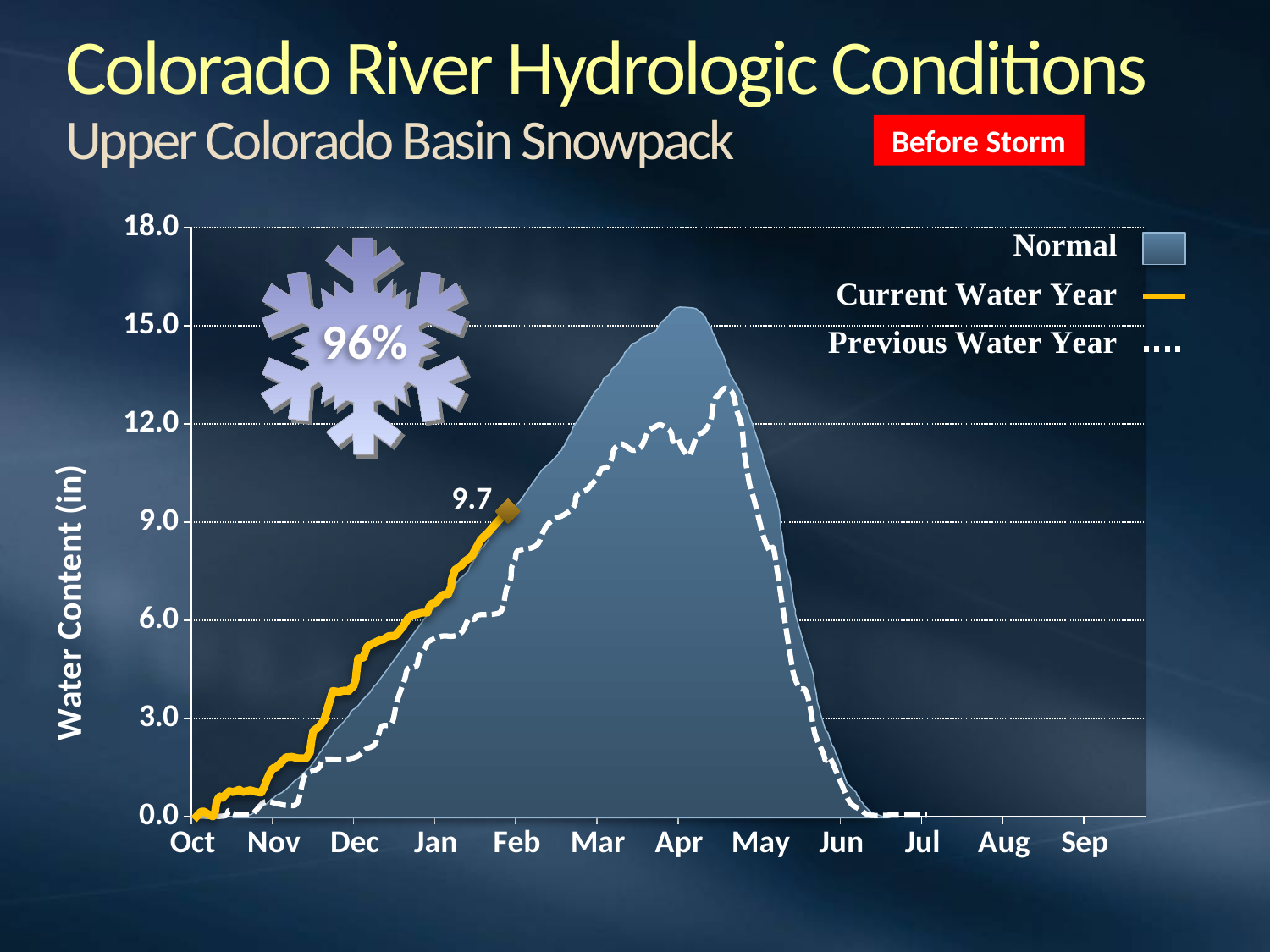
Is the peak value of the Previous Water Year series greater or less than 15.0? less At Jan, which is higher: the Current Water Year or the Previous Water Year? Current Water Year Is the Current Water Year value at Nov greater or less than 3.0? less What is the labelled value at the end of the Current Water Year line? 9.7 How many series does the legend list? 3 What kind of chart is used to plot the Current Water Year and Previous Water Year series? line chart Is the peak value of the Normal series greater or less than 15.0? greater In which month does the Normal series reach its highest value? Apr What percentage is shown inside the snowflake on the chart? 96% Does the Current Water Year line rise or fall from Oct to Feb? rises How many month labels are shown on the x axis? 12